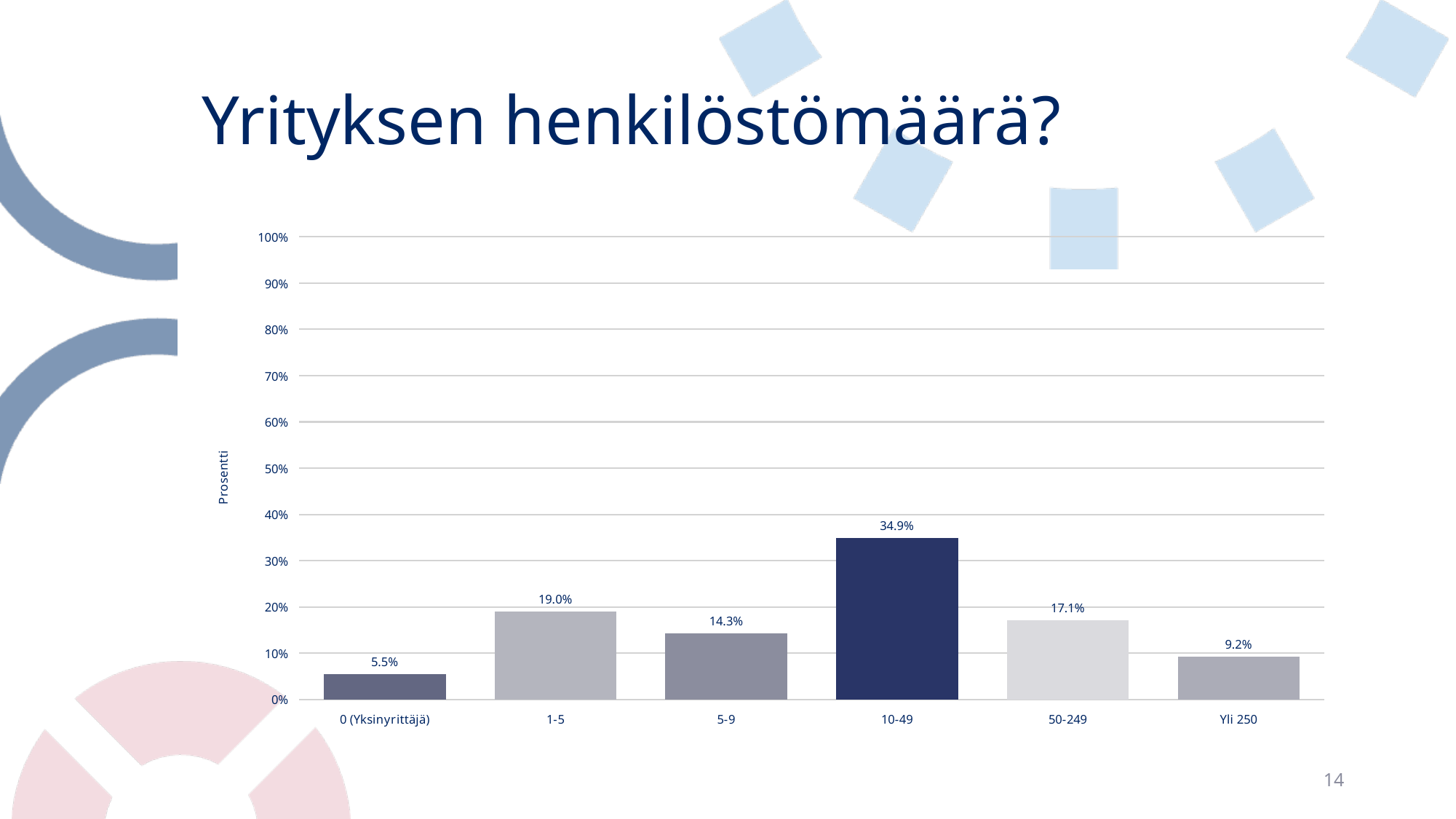
What kind of chart is shown on the slide? bar chart Which category has the highest value? 10-49 How many categories are shown on the x axis? 6 What is the difference between the values for 1-5 and 5-9? 4.7% What is the label of the vertical axis? Prosentti Which category has the lowest value? 0 (Yksinyrittäjä) What is the value for the 50-249 category? 17.1% What is the value for the 10-49 category? 34.9% What is the value for the 0 (Yksinyrittäjä) category? 5.5% What is the value for the Yli 250 category? 9.2% Which is larger, the value for 1-5 or the value for 50-249? 1-5 Is the value for 10-49 greater or less than 30%? greater